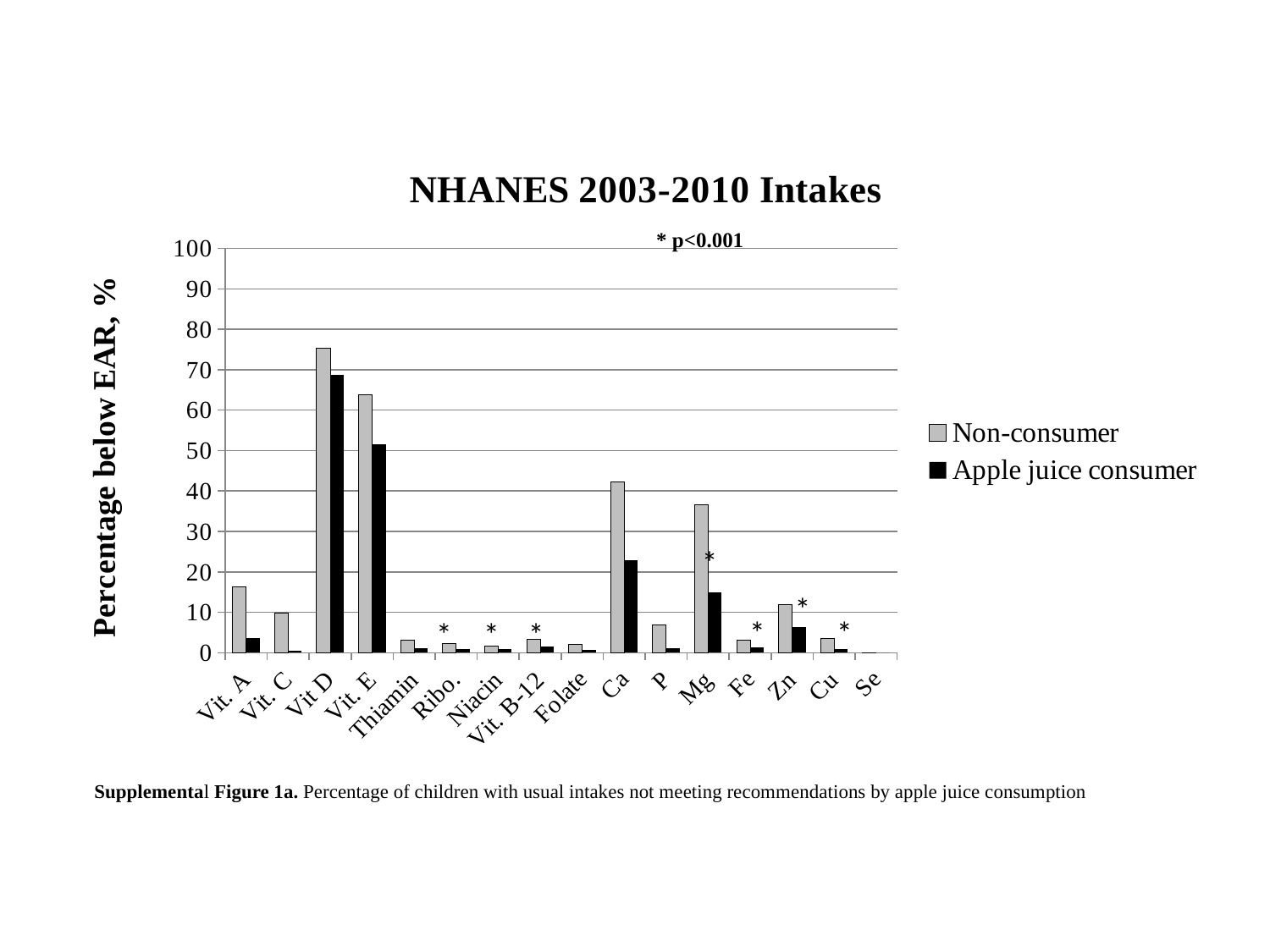
Is the Non-consumer value for Mg greater or less than 30? greater How many series does the legend list? 2 What type of chart is shown on the slide? bar chart For Vit D, which series has the larger value, Non-consumer or Apple juice consumer? Non-consumer Is the Non-consumer value for Vit. E greater or less than 60? greater What is the title of the chart? NHANES 2003-2010 Intakes Which nutrient has the highest Apple juice consumer value? Vit D Is the Apple juice consumer value for Ca greater or less than 30? less How many nutrient categories are shown on the x axis? 16 For the Non-consumer series, which is larger, Ca or Mg? Ca Which nutrient has the highest Non-consumer value? Vit D